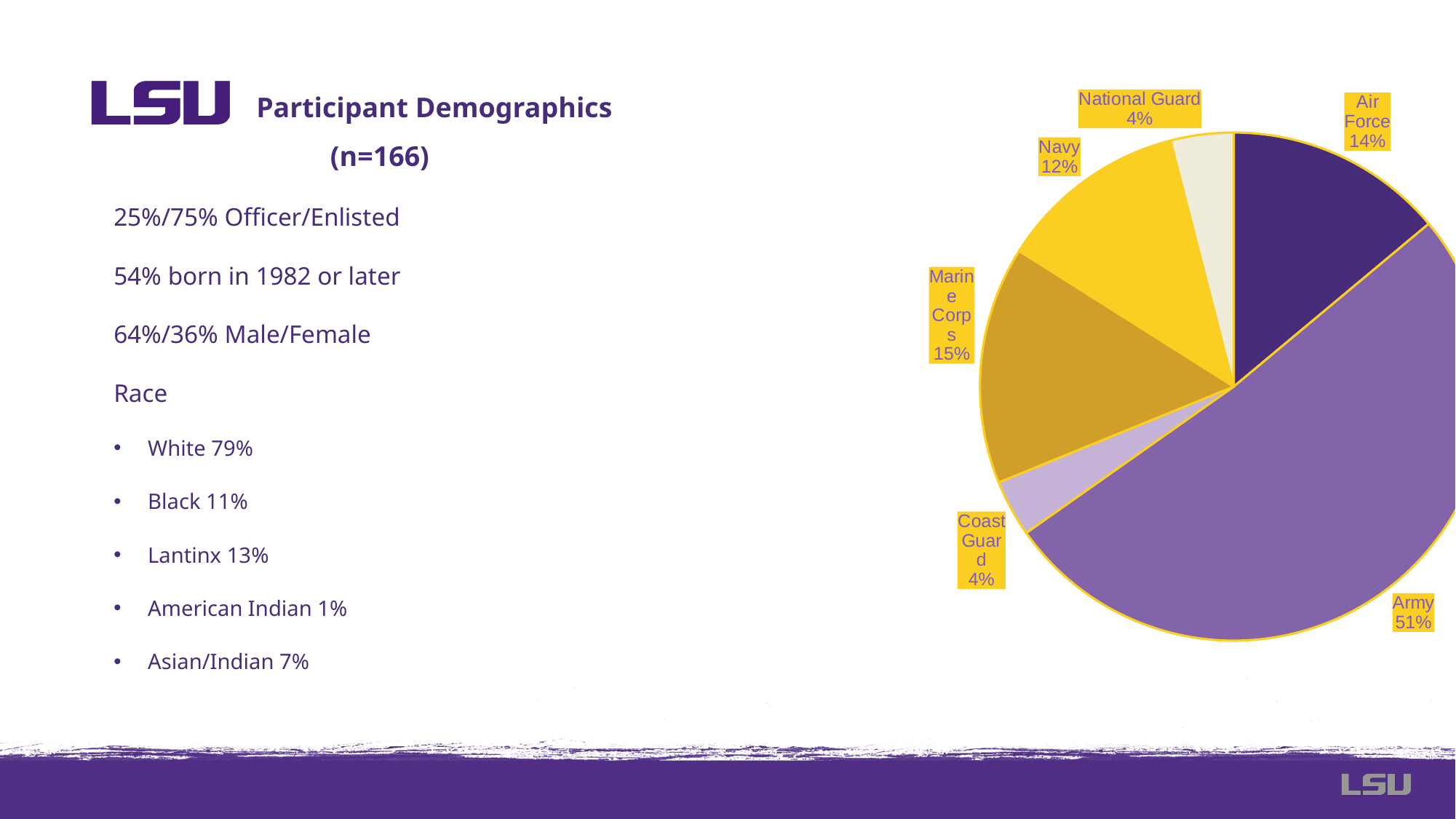
What percentage is shown for the Navy slice? 12% What percentage is shown for the Marine Corps slice? 15% What kind of chart is shown on the slide? pie chart What share of participants does the Army slice represent? 51% What percentage is shown for the Air Force slice? 14% What is the difference in percentage points between the Army slice and the Marine Corps slice? 36 What is the combined percentage of the Navy and National Guard slices? 16% Which two branches share the same percentage of 4% in the pie chart? National Guard and Coast Guard How many slices does the pie chart have? 6 Which branch has the largest slice of the pie chart? Army Which slice is larger, Navy or Air Force? Air Force What percentage is shown for the Coast Guard slice? 4%